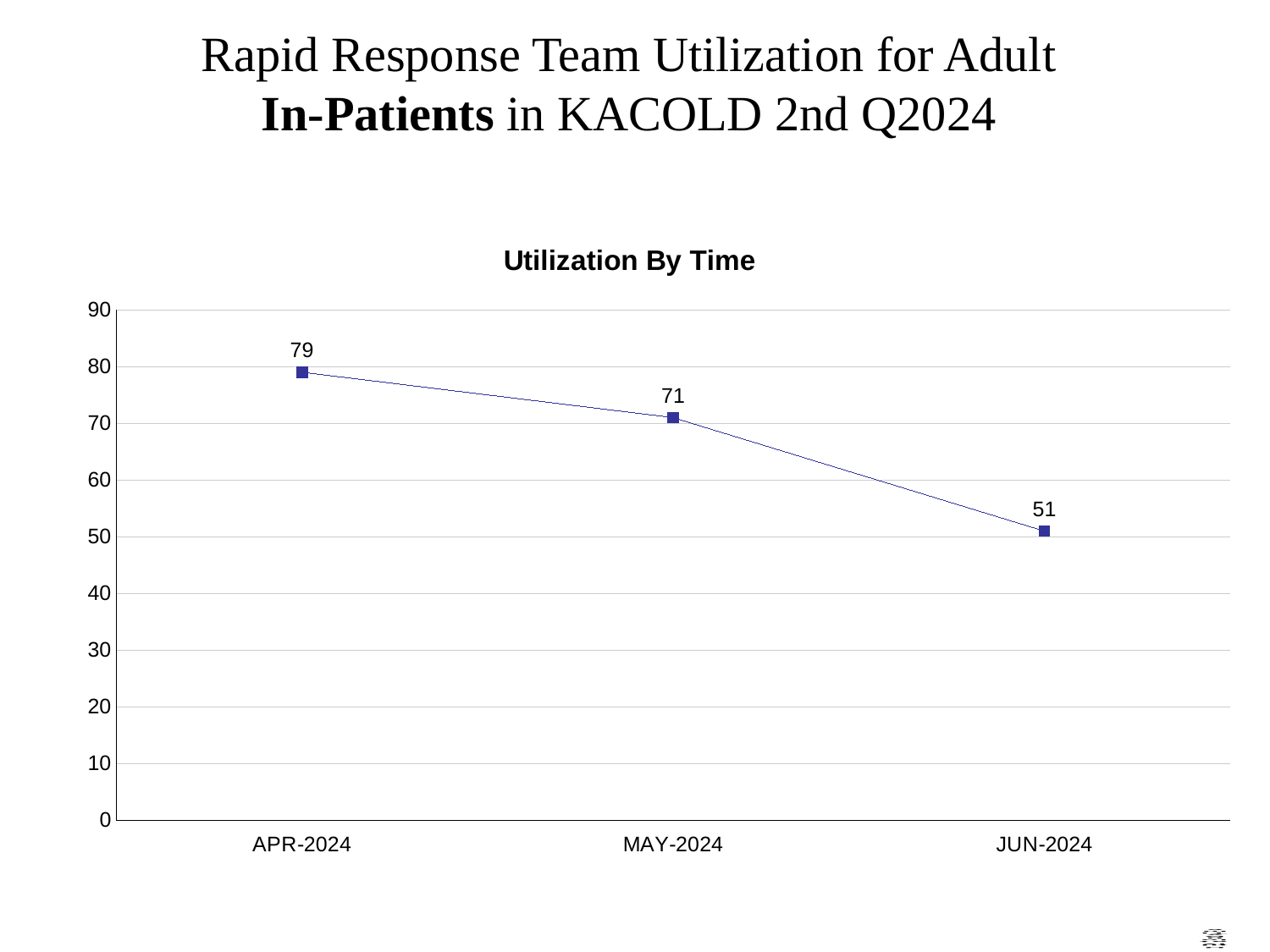
Which month has the highest utilization value? APR-2024 Do the values rise or fall from APR-2024 to JUN-2024? fall What is the utilization value for APR-2024? 79 What is the difference between the utilization values for MAY-2024 and JUN-2024? 20 What is the utilization value for MAY-2024? 71 Which month has the lowest utilization value? JUN-2024 Which is larger, the value for MAY-2024 or the value for JUN-2024? MAY-2024 Is the value for JUN-2024 greater or less than 60? less What is the utilization value for JUN-2024? 51 What is the difference between the utilization values for APR-2024 and JUN-2024? 28 What kind of chart is shown on the slide? line chart How many months are plotted on the chart? 3